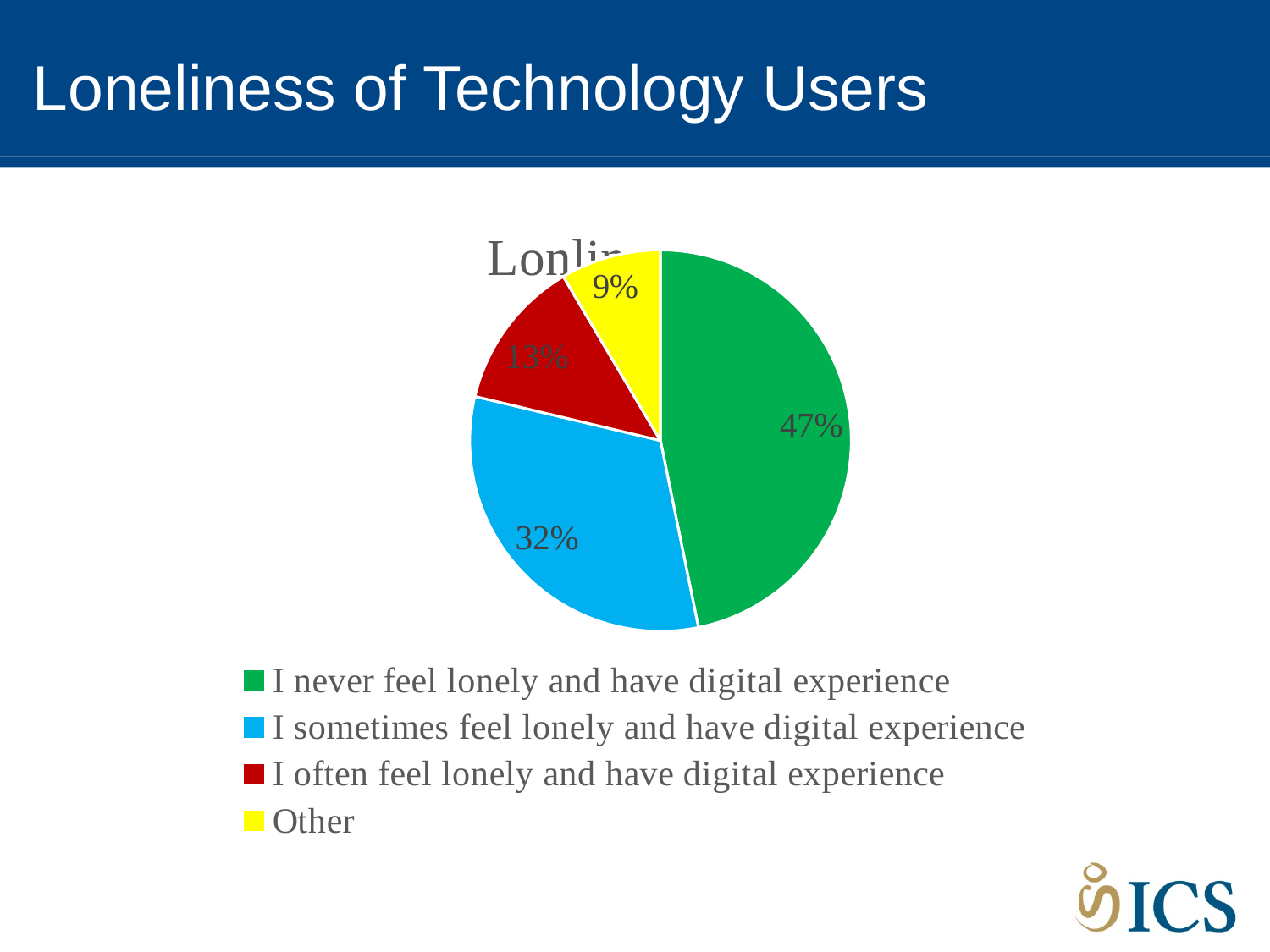
What is the difference in percentage points between "I never feel lonely and have digital experience" and "I sometimes feel lonely and have digital experience"? 15 percentage points How many entries does the legend list? 4 What percentage of the pie is for "Other"? 9% What colour is the slice for "I sometimes feel lonely and have digital experience"? Blue Which category has the largest share of the pie? I never feel lonely and have digital experience Which is larger: the share for "I often feel lonely and have digital experience" or the share for "Other"? I often feel lonely and have digital experience Which category has the smallest share of the pie? Other What percentage of the pie is for "I never feel lonely and have digital experience"? 47% How many slices does the pie chart have? 4 What percentage of the pie is for "I sometimes feel lonely and have digital experience"? 32% What percentage of the pie is for "I often feel lonely and have digital experience"? 13% What kind of chart is shown on the slide? Pie chart